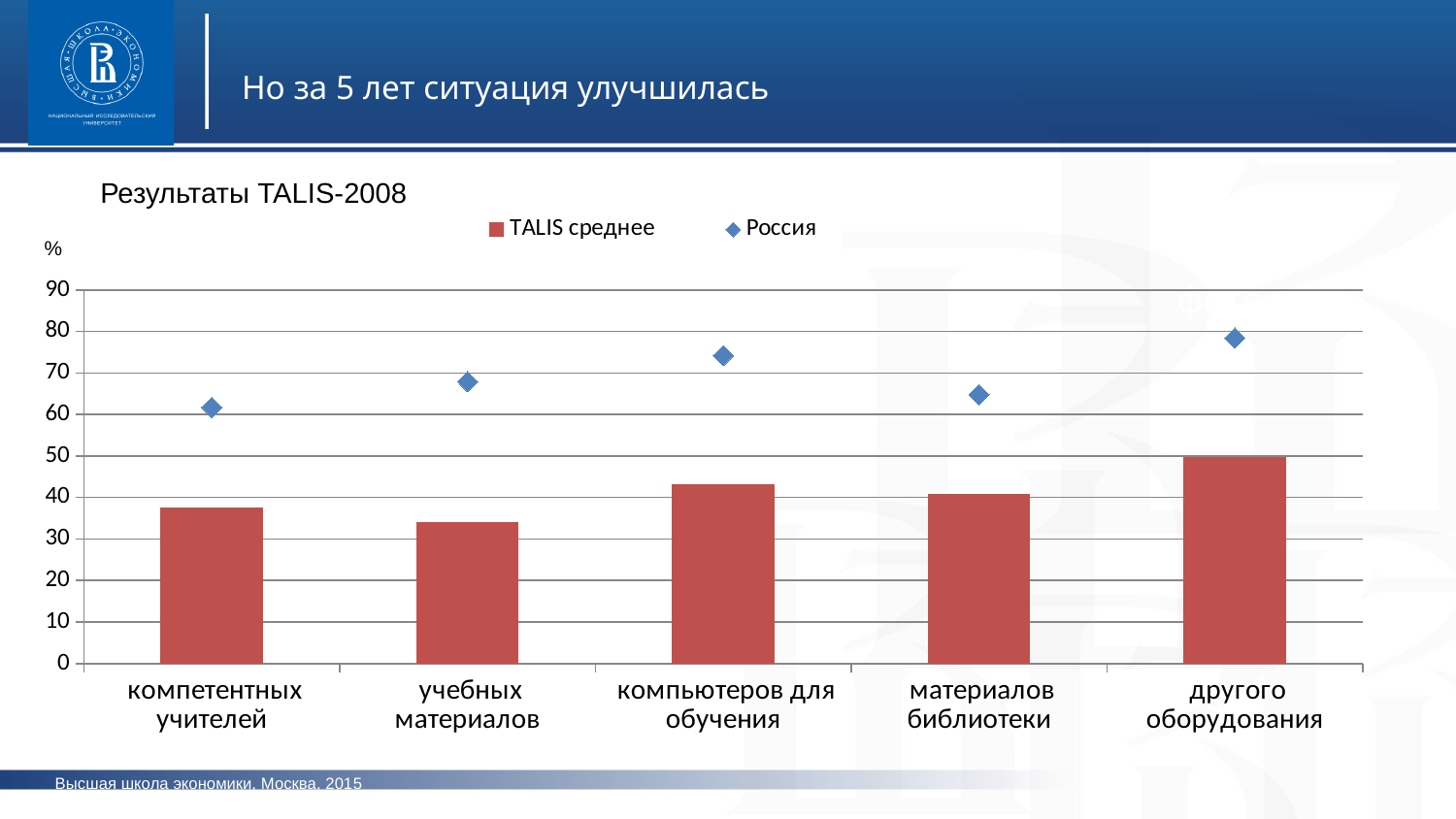
Is the Россия value for компетентных учителей greater or less than 70? less Is the TALIS среднее value for компьютеров для обучения greater or less than 40? greater What is the title of the chart? Результаты TALIS-2008 How many categories are shown on the x axis? 5 How many series does the legend list? 2 For материалов библиотеки, which is larger: the Россия value or the TALIS среднее value? Россия What kind of chart is shown on the slide? A bar chart with a point (marker) series Which category has the highest value for Россия? другого оборудования Which category has the highest value for TALIS среднее? другого оборудования Is the TALIS среднее value for учебных материалов greater or less than 40? less Which series is shown with blue diamond markers? Россия